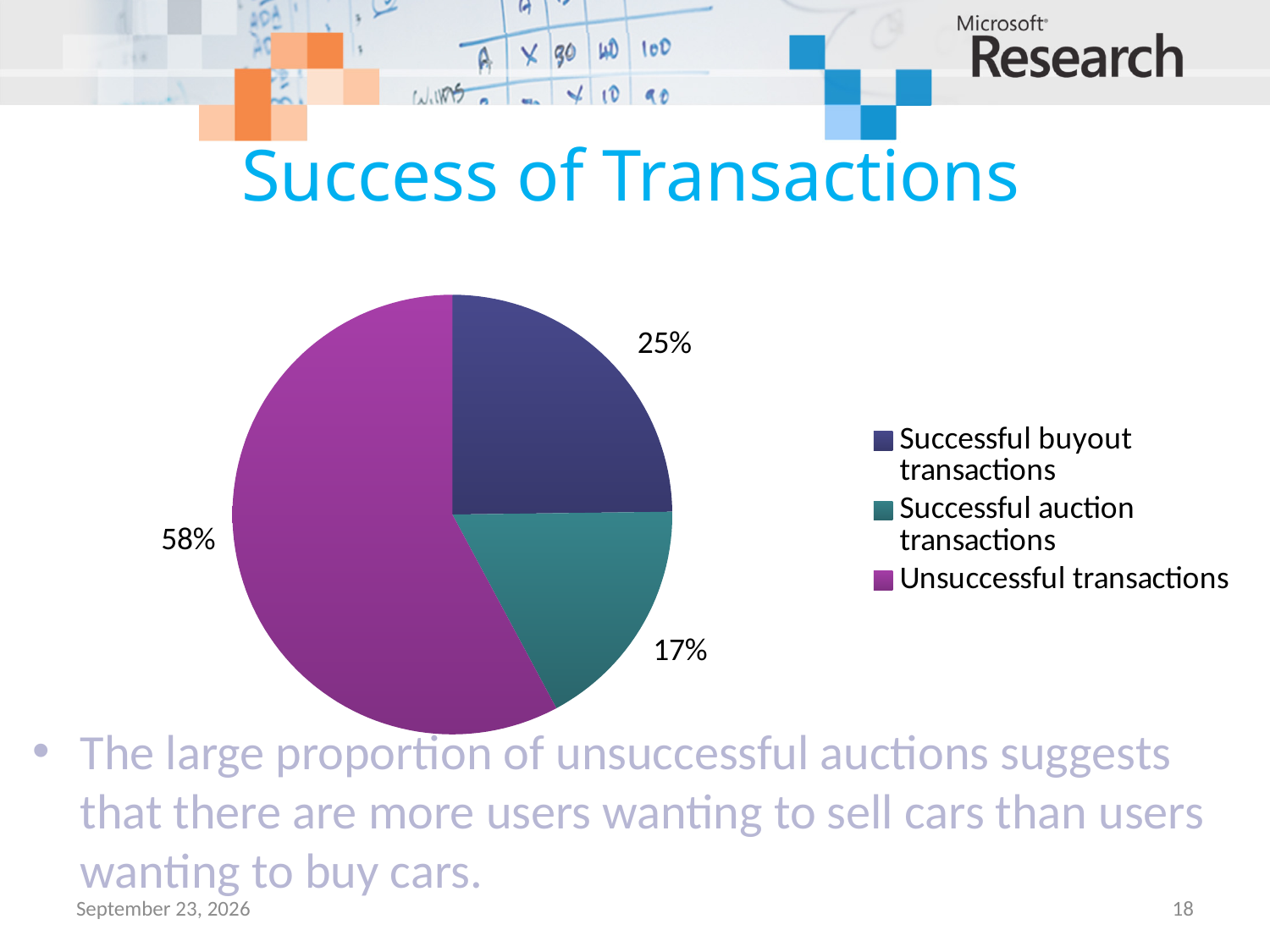
What is the difference in percentage points between Unsuccessful transactions and Successful buyout transactions? 33 Which is larger: Successful buyout transactions or Successful auction transactions? Successful buyout transactions What share of the pie is Successful buyout transactions? 25% What colour is the Unsuccessful transactions slice? purple What share of the pie is Unsuccessful transactions? 58% What is the title of the slide containing the chart? Success of Transactions How many slices does the pie chart have? 3 What kind of chart is shown on the slide? pie chart What share of the pie is Successful auction transactions? 17% What is the difference in percentage points between Successful buyout transactions and Successful auction transactions? 8 Which category has the smallest slice of the pie? Successful auction transactions Which category has the largest slice of the pie? Unsuccessful transactions